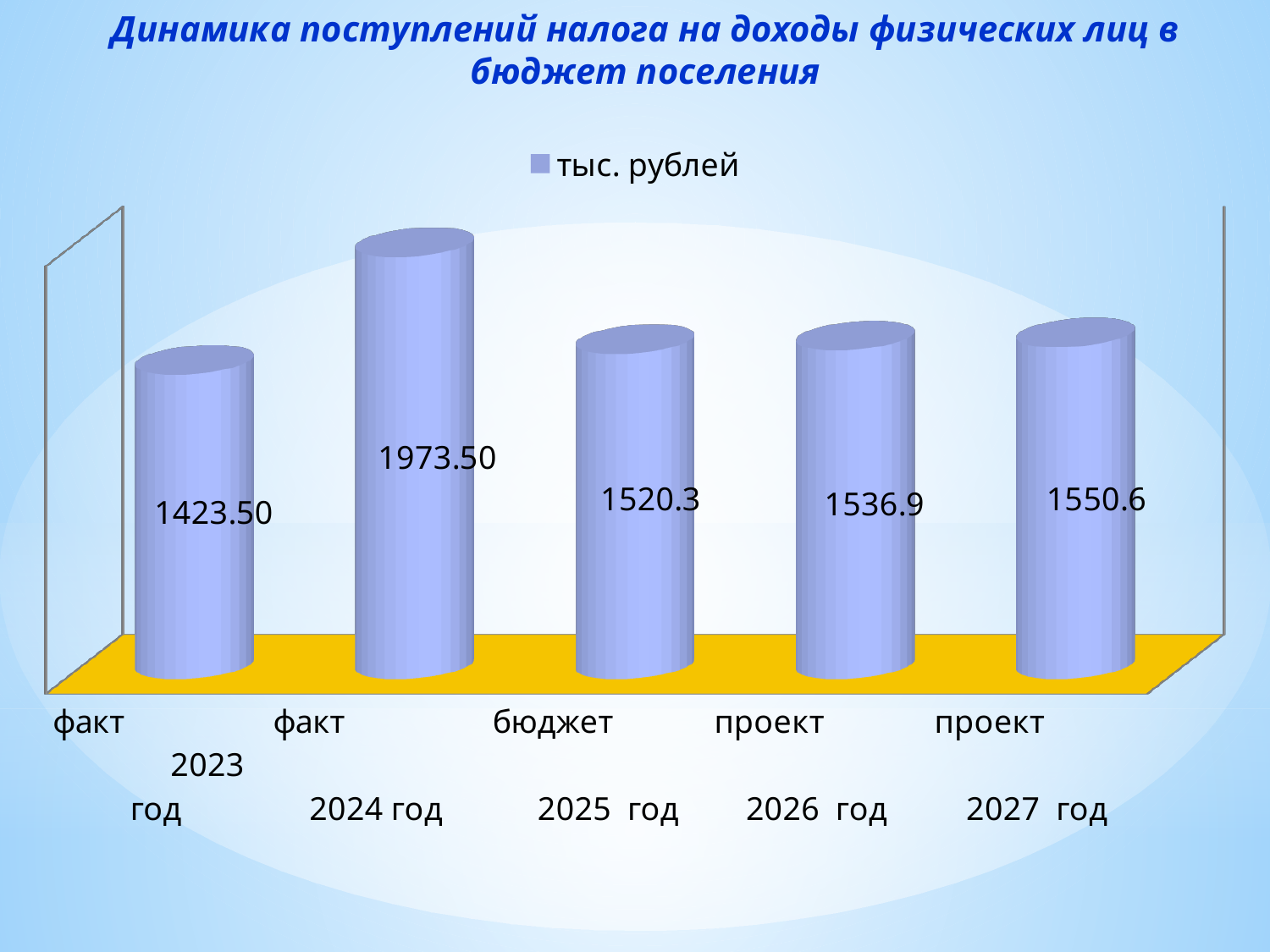
What series name does the legend show? тыс. рублей Which category has the highest value? факт 2024 год Which category has the lowest value? факт 2023 год Which is larger, the value for проект 2026 год or the value for бюджет 2025 год? проект 2026 год What is the difference between the values for факт 2024 год and факт 2023 год? 550.00 What is the value for факт 2024 год? 1973.50 What is the value for факт 2023 год? 1423.50 What is the value for бюджет 2025 год? 1520.3 How many categories are shown on the chart? 5 What is the value for проект 2027 год? 1550.6 What kind of chart is shown on the slide? bar chart What is the difference between the values for проект 2027 год and бюджет 2025 год? 30.3